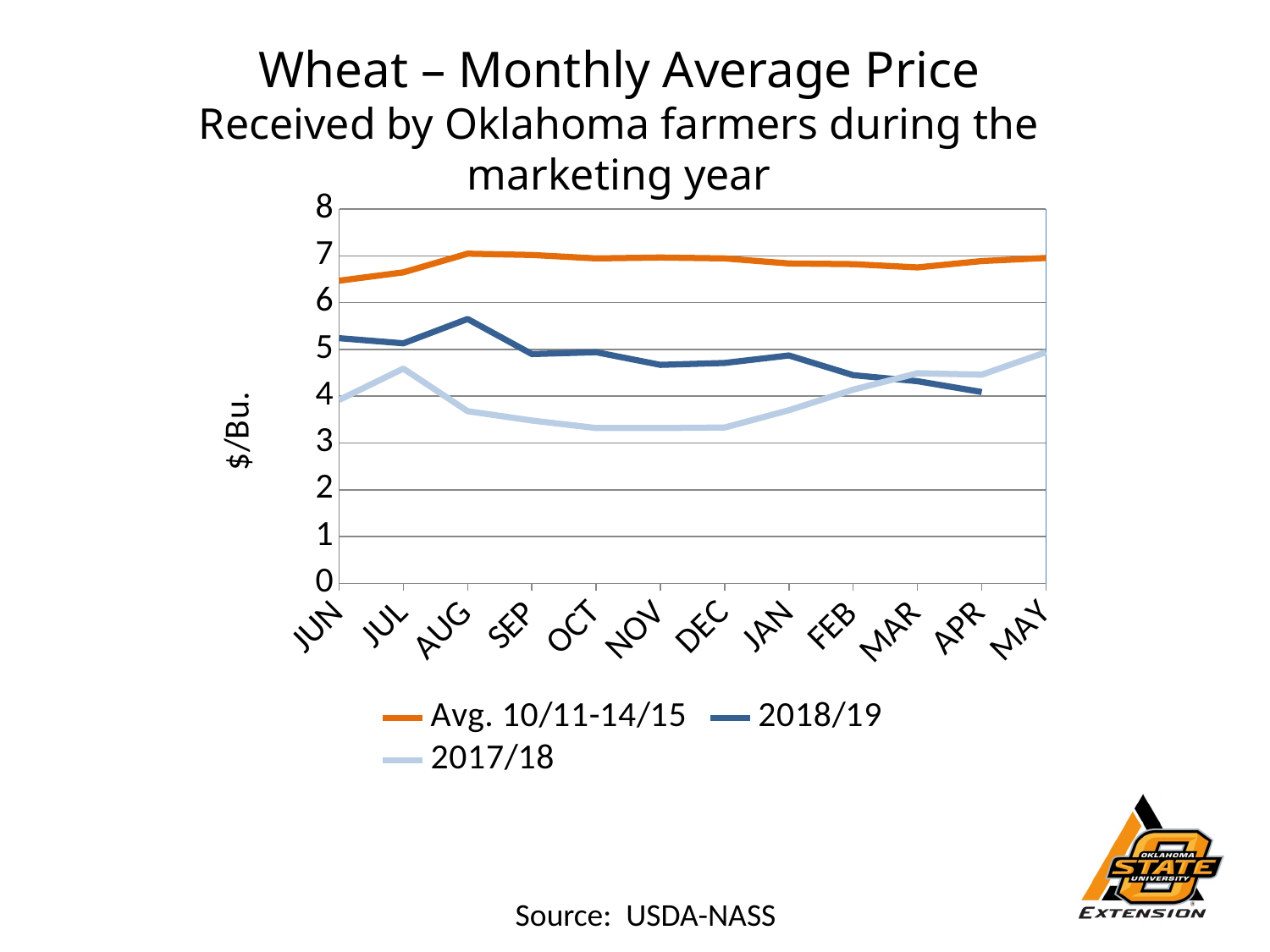
In JUL, which series has the larger value: 2018/19 or 2017/18? 2018/19 In which month does the 2018/19 series reach its lowest value? APR Is the value for the Avg. 10/11-14/15 series in MAR greater or less than 7? less Does the 2017/18 series rise or fall from DEC to MAY? rise Is the value for the 2017/18 series in JUL greater or less than 4? greater What kind of chart is shown on the slide? Line chart How many months are shown along the x axis? 12 Is the value for the 2017/18 series in OCT greater or less than 4? less In which month does the 2018/19 series reach its highest value? AUG How many series does the legend list? 3 What is the label on the y axis? $/Bu.